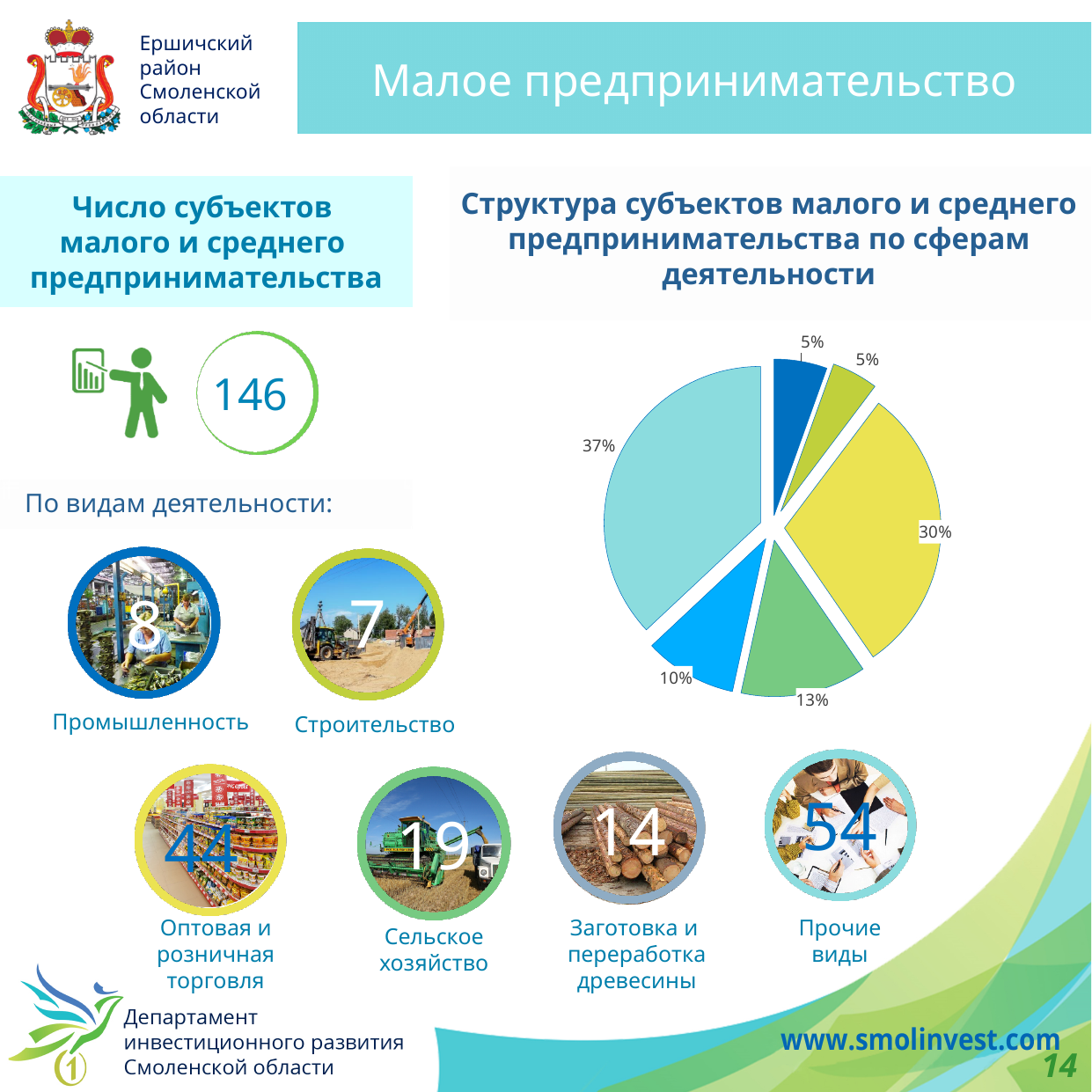
What is the share of the green slice in the pie chart? 13% What is the share of the largest slice in the pie chart? 37% How many slices in the pie chart are labelled 5%? 2 What is the share of the yellow slice in the pie chart? 30% What is the combined share of the 13% and 10% slices in the pie chart? 23% Which is larger in the pie chart: the yellow slice or the green slice? the yellow slice What is the title of the chart on the slide? Структура субъектов малого и среднего предпринимательства по сферам деятельности How many slices does the pie chart have? 6 What kind of chart is shown on the slide? pie chart What is the share of the light blue (largest) slice in the pie chart? 37% What is the share of the smallest slices in the pie chart? 5% What is the difference between the largest slice (37%) and the yellow slice (30%) in the pie chart? 7%